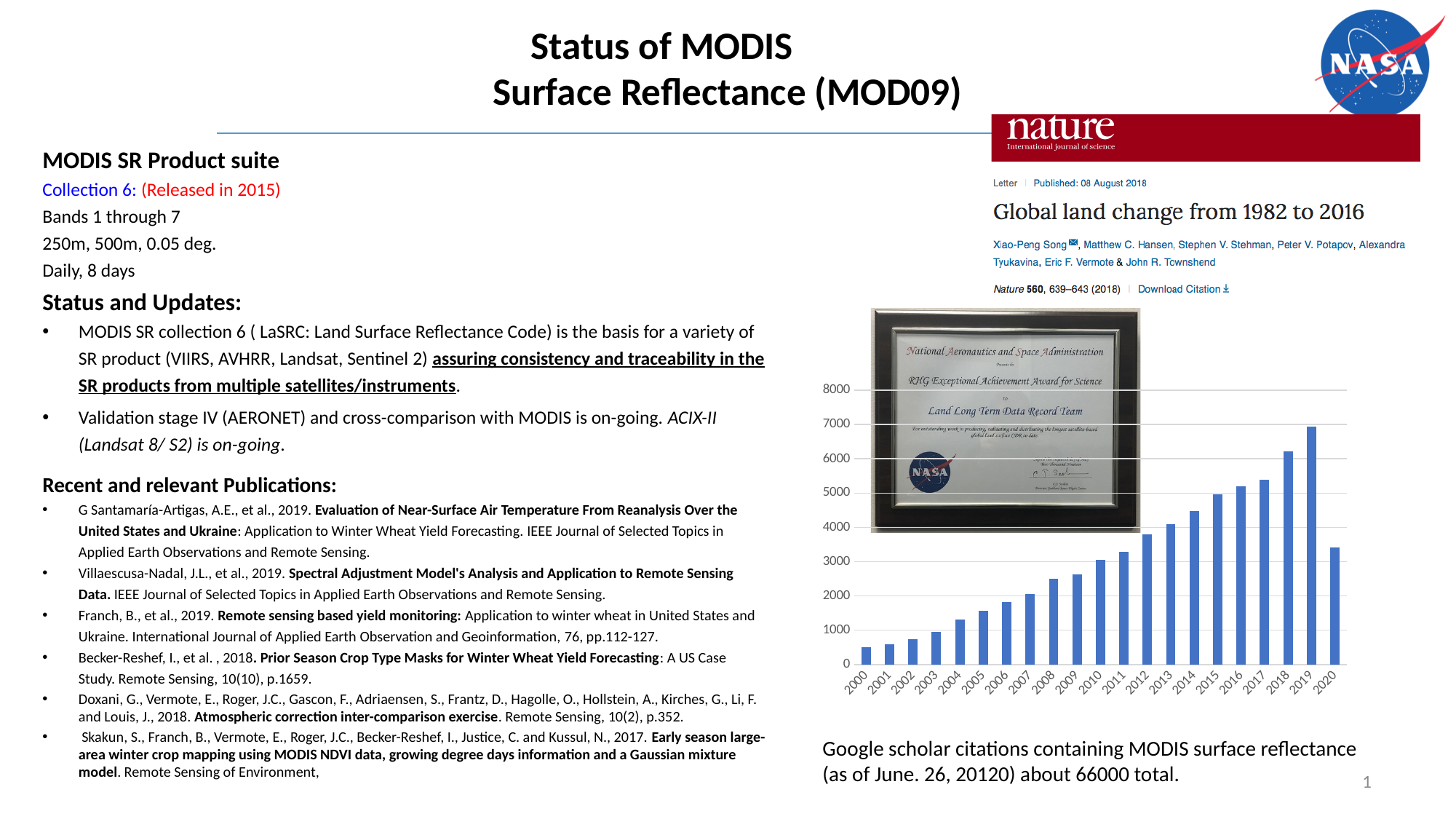
Which year has the larger value, 2018 or 2020? 2018 Is the value for 2019 greater or less than 6000? greater Which year has the tallest bar in the chart? 2019 Which year has the shortest bar in the chart? 2000 What kind of chart is shown on the slide? bar chart What is the first year shown on the x axis of the chart? 2000 Which year has the larger value, 2005 or 2010? 2010 How many years are shown on the x axis of the bar chart? 21 Is the value for 2012 greater or less than 3000? greater Is the value for 2000 greater or less than 1000? less Do the bar values generally rise or fall from 2000 to 2019? rise